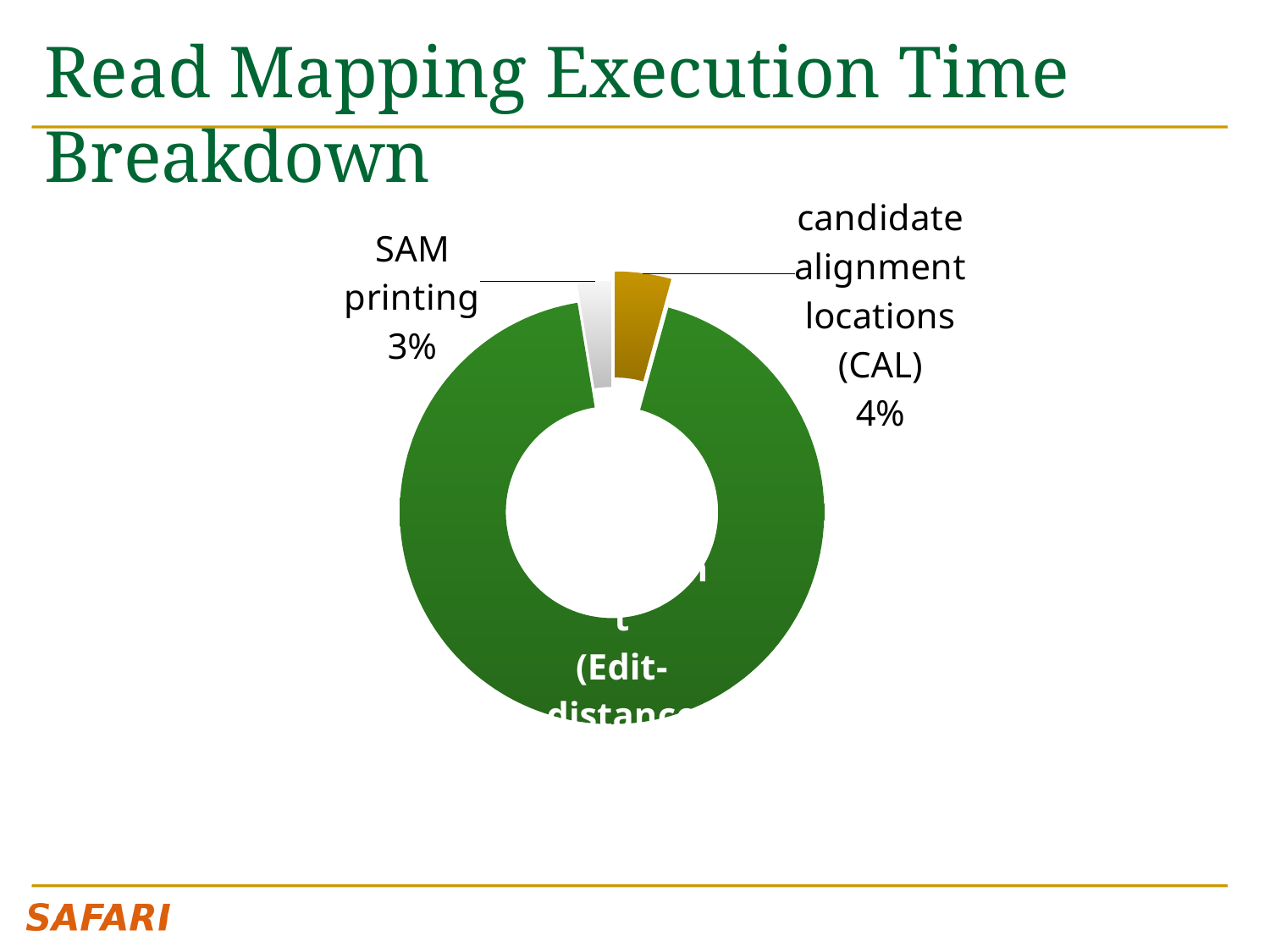
What is the title of the slide containing the chart? Read Mapping Execution Time Breakdown What kind of chart is shown on the slide? doughnut chart Which takes a larger share of execution time, SAM printing or candidate alignment locations (CAL)? candidate alignment locations (CAL) How many slices does the chart contain? 3 Which labelled category has the smallest share of execution time? SAM printing What colour is the slice representing candidate alignment locations (CAL)? gold What percentage of execution time is attributed to candidate alignment locations (CAL)? 4% By how many percentage points does the CAL share exceed the SAM printing share? 1% What percentage of read mapping execution time is spent on SAM printing? 3%